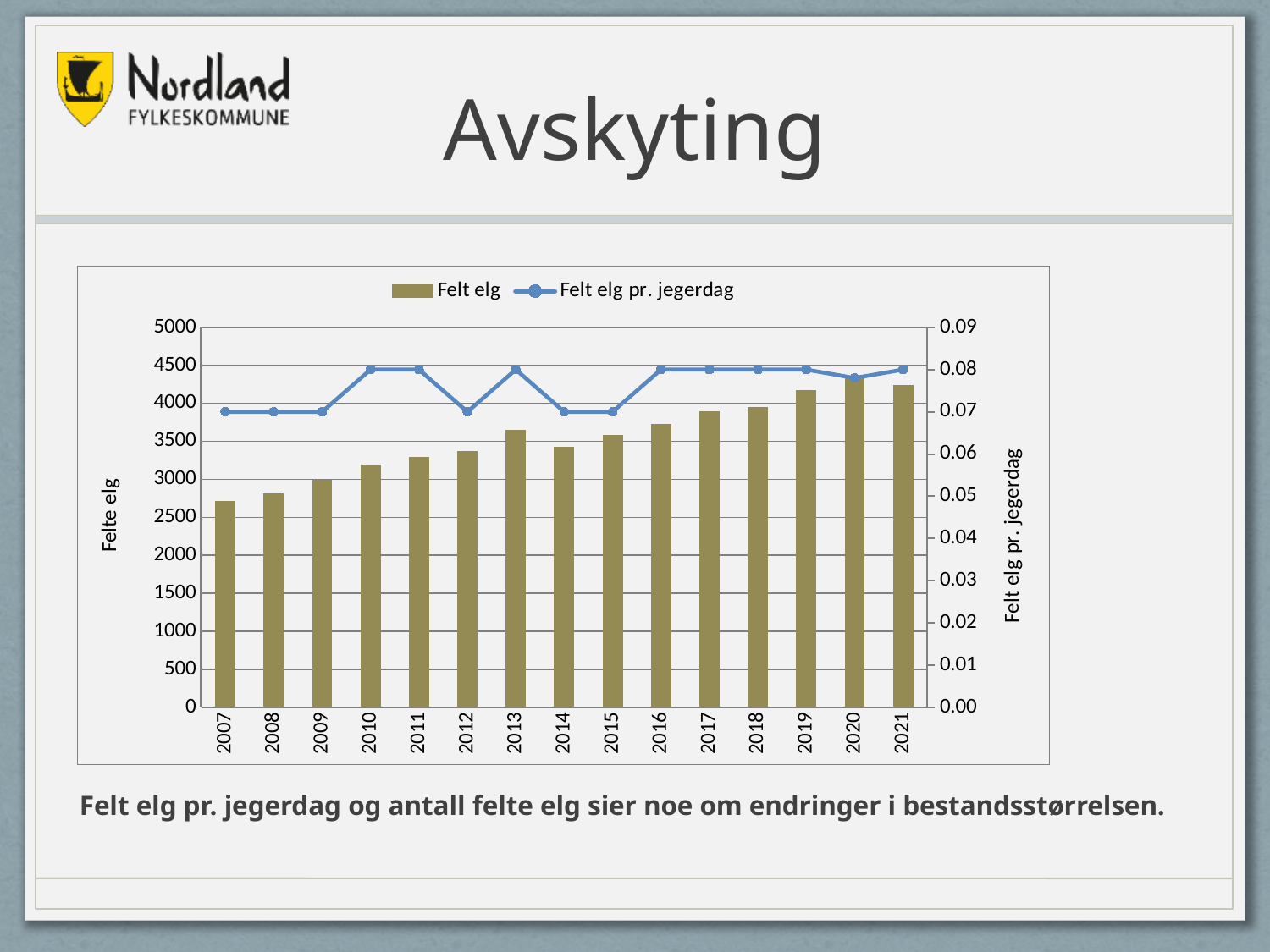
What kind of chart is shown on the slide? A combined bar and line chart Is the Felt elg value for 2012 greater or less than 3500? less How many years are shown on the x axis? 15 Which year has the highest bar for Felt elg? 2020 Is the Felt elg value for 2021 greater or less than 4000? greater How many series does the legend list? 2 Do the Felt elg bars generally rise or fall from 2007 to 2021? rise What is the Felt elg pr. jegerdag value for 2007? 0.07 What is the label of the right-hand vertical axis? Felt elg pr. jegerdag Is the Felt elg value for 2007 greater or less than 3000? less What is the Felt elg pr. jegerdag value for 2010? 0.08 Which year has the lowest bar for Felt elg? 2007